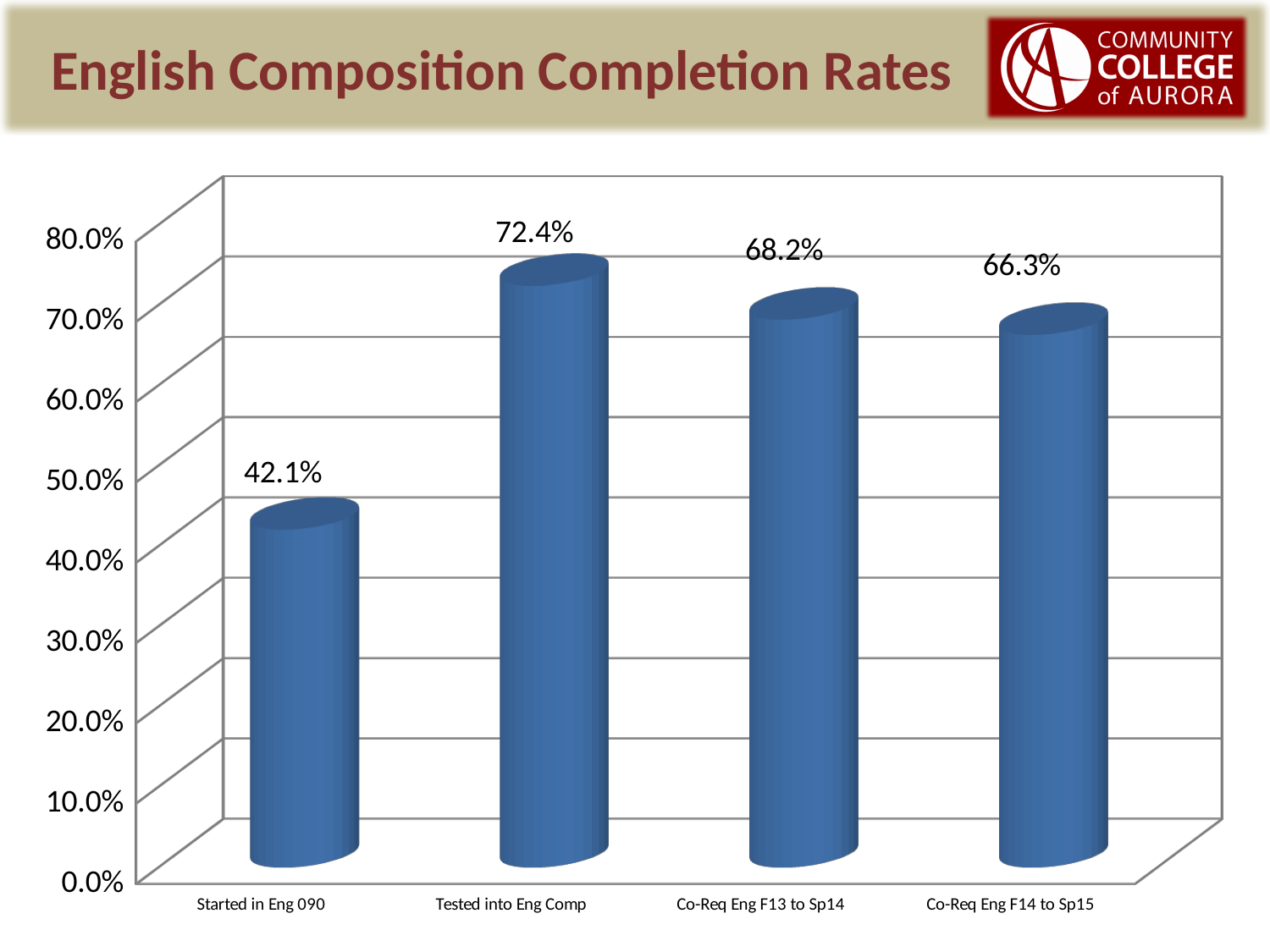
What is the completion rate for Co-Req Eng F14 to Sp15? 66.3% How many categories are shown on the chart? 4 What is the completion rate for students who Started in Eng 090? 42.1% What kind of chart is shown on the slide? Bar chart What is the difference between the completion rates for Co-Req Eng F13 to Sp14 and Co-Req Eng F14 to Sp15? 1.9% Which category has the highest completion rate? Tested into Eng Comp What is the difference between the completion rates for Tested into Eng Comp and Started in Eng 090? 30.3% Which category has the lowest completion rate? Started in Eng 090 Which is larger, the completion rate for Co-Req Eng F13 to Sp14 or for Started in Eng 090? Co-Req Eng F13 to Sp14 What is the completion rate for Co-Req Eng F13 to Sp14? 68.2% What is the title of the slide containing the chart? English Composition Completion Rates What is the completion rate for students who Tested into Eng Comp? 72.4%